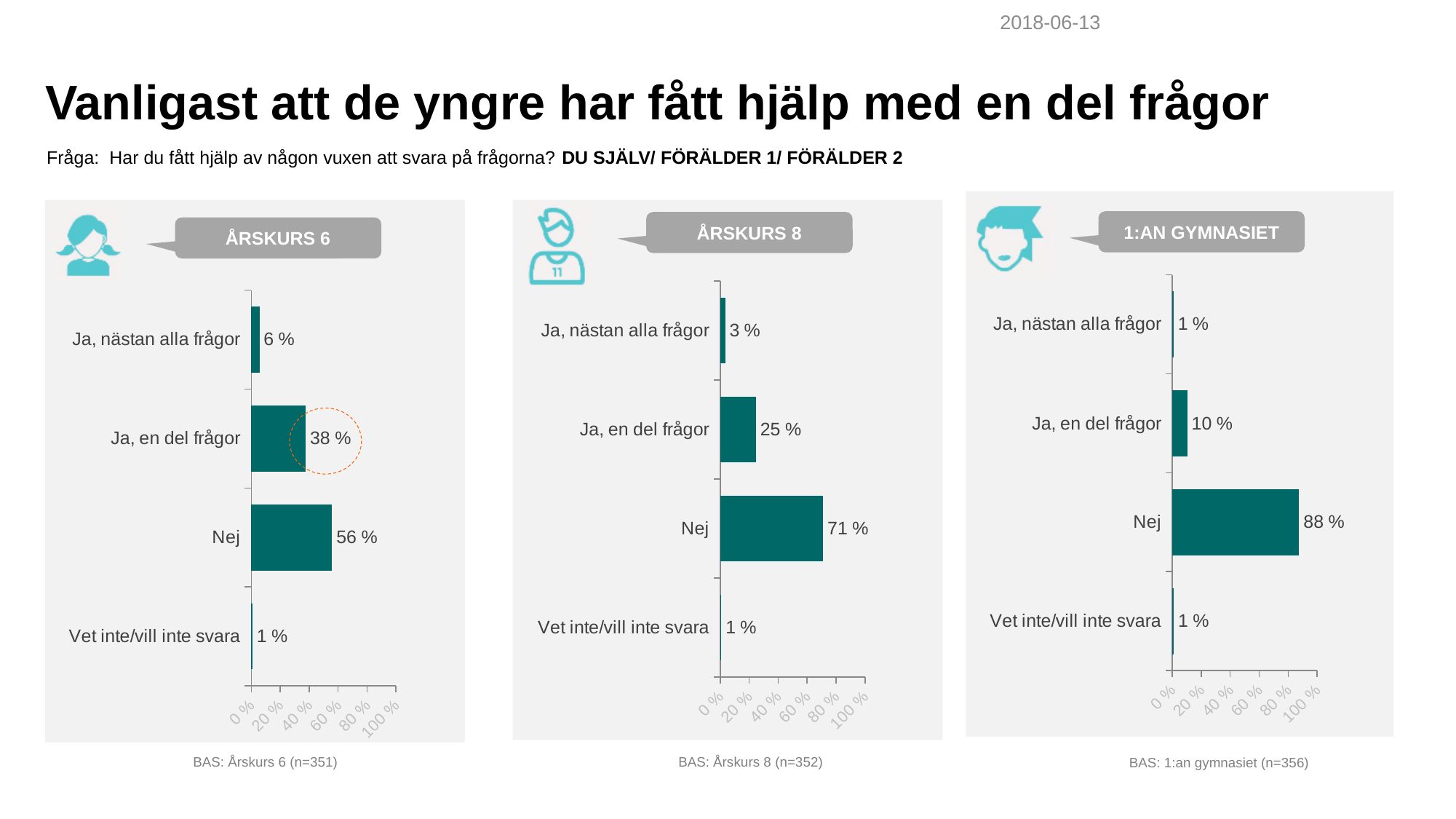
How many categories does the ÅRSKURS 8 chart show? 4 In the ÅRSKURS 8 chart, what is the value for "Nej"? 71 % In the ÅRSKURS 6 chart, what is the value for "Ja, en del frågor"? 38 % In the 1:AN GYMNASIET chart, is the value for "Nej" greater or less than 80 %? greater In the 1:AN GYMNASIET chart, which category has the highest value? Nej Which is larger: "Ja, nästan alla frågor" in the ÅRSKURS 6 chart or "Ja, nästan alla frågor" in the ÅRSKURS 8 chart? ÅRSKURS 6 In the ÅRSKURS 8 chart, what is the difference between "Nej" and "Ja, en del frågor"? 46 % In the 1:AN GYMNASIET chart, what is the value for "Ja, en del frågor"? 10 % What kind of chart is the ÅRSKURS 6 chart? bar chart In the ÅRSKURS 6 chart, what is the difference between "Nej" and "Ja, en del frågor"? 18 % In the ÅRSKURS 6 chart, which category has the highest value? Nej In the ÅRSKURS 8 chart, which category has the lowest value? Vet inte/vill inte svara